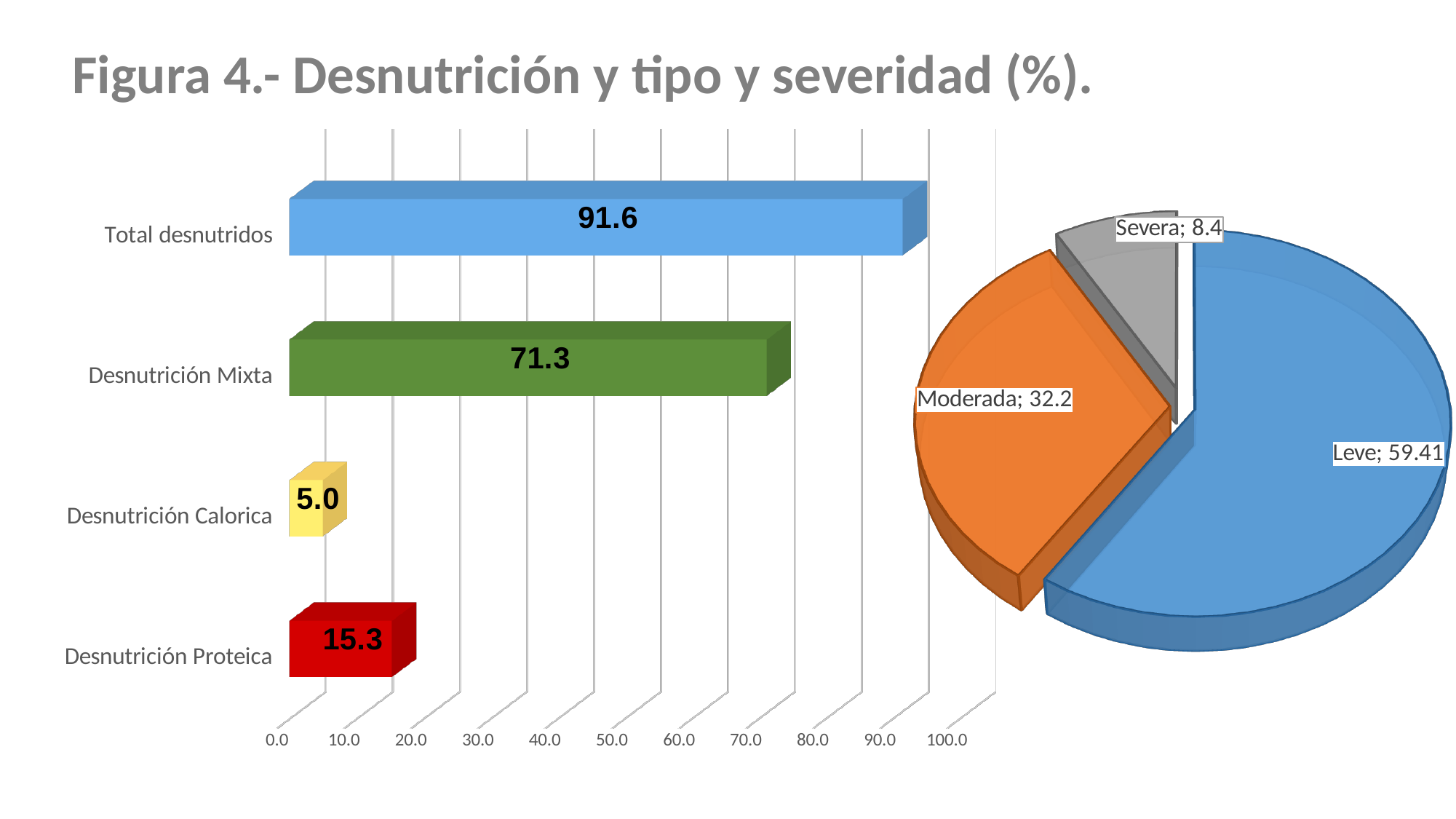
In the bar chart on the left, what is the value for Desnutrición Calorica? 5.0 In the bar chart on the left, what is the value for Total desnutridos? 91.6 In the pie chart on the right, what is the value for Moderada? 32.2 In the bar chart on the left, which is larger: Desnutrición Proteica or Desnutrición Calorica? Desnutrición Proteica In the bar chart on the left, what is the value for Desnutrición Mixta? 71.3 What kind of chart is on the left side of the slide? Bar chart In the bar chart on the left, which category has the lowest value? Desnutrición Calorica In the bar chart on the left, what is the difference between Total desnutridos and Desnutrición Mixta? 20.3 In the pie chart on the right, which slice is the largest? Leve In the bar chart on the left, which category has the highest value? Total desnutridos In the pie chart on the right, what is the value for Severa? 8.4 In the bar chart on the left, how many categories are shown? 4